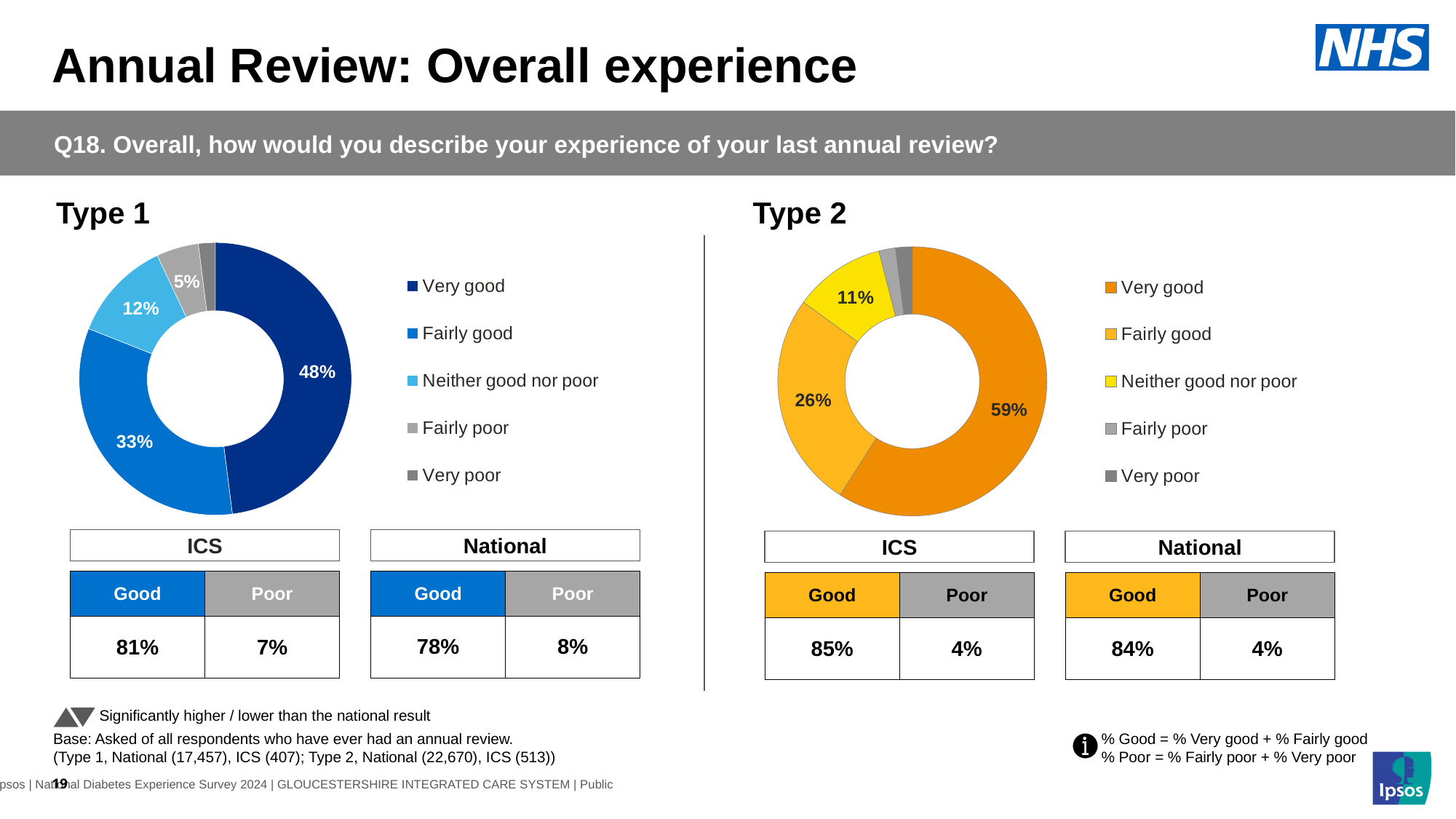
Which is larger: the Fairly good share in the Type 1 chart or the Fairly good share in the Type 2 chart? Type 1 How many response categories does the legend of the Type 1 chart list? 5 In the Type 1 chart, what percentage said Fairly good? 33% In the Type 2 chart, what percentage said Neither good nor poor? 11% What is the difference between the Very good share in the Type 2 chart and the Very good share in the Type 1 chart? 11 percentage points In the Type 1 chart, which response category has the largest share? Very good In the Type 2 chart, which response category has the largest share? Very good In the Type 1 chart, what percentage said Neither good nor poor? 12% What type of chart is used to show the Type 2 results? Donut (pie) chart In the Type 2 chart, what percentage said Fairly good? 26% In the Type 1 chart, what percentage of respondents said their experience was Very good? 48% In the Type 2 chart, what percentage of respondents said Very good? 59%